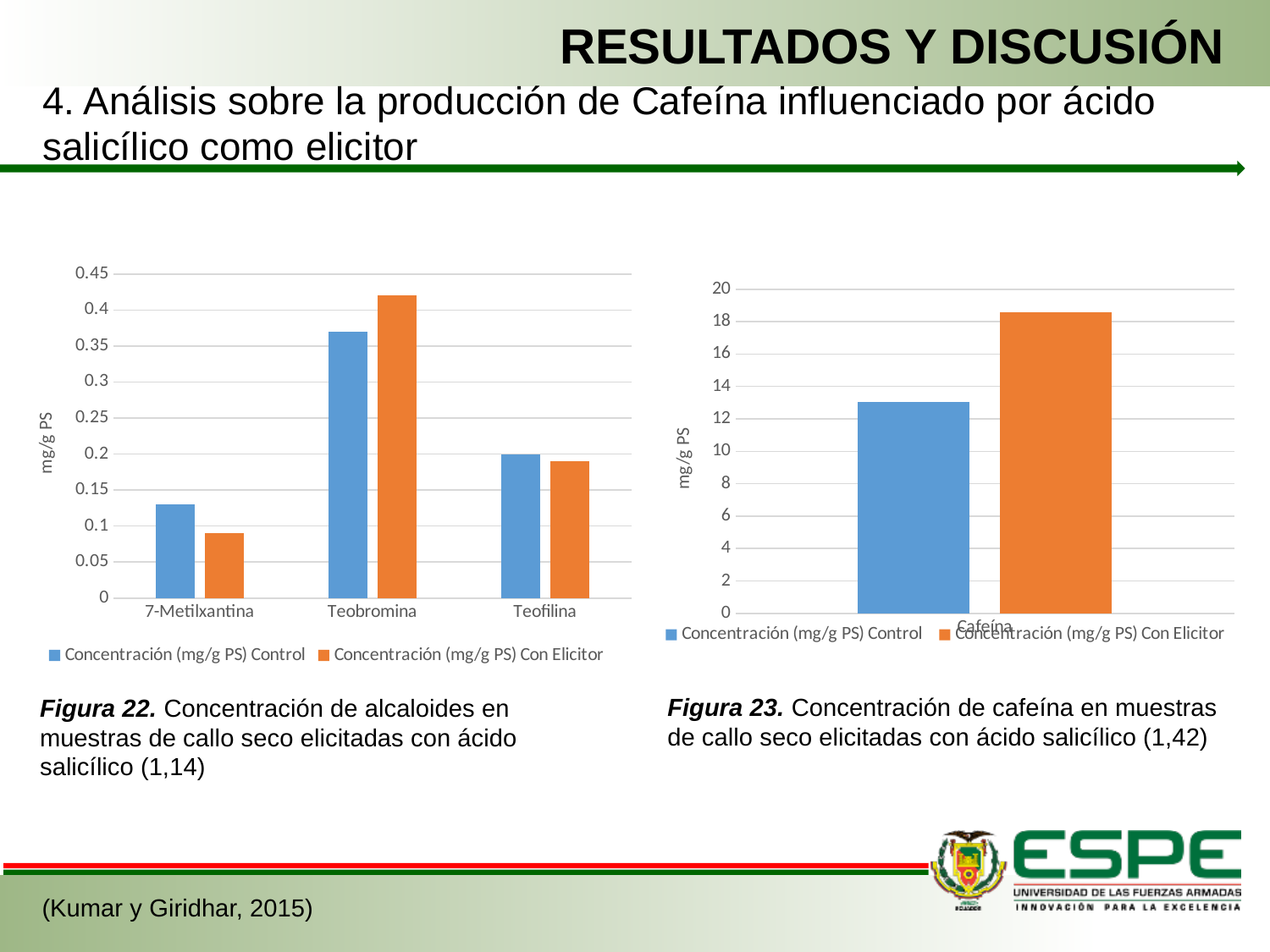
In the left chart (Figura 22), which category has the lowest Concentración (mg/g PS) Control value? 7-Metilxantina In the left chart (Figura 22), is the Concentración (mg/g PS) Con Elicitor value for 7-Metilxantina greater or less than 0.1? less In the right chart (Figura 23), is the Concentración (mg/g PS) Con Elicitor value for Cafeína greater or less than 18? greater In the left chart (Figura 22), how many series does the legend list? 2 In the left chart (Figura 22), is the Concentración (mg/g PS) Con Elicitor value for Teobromina greater or less than 0.4? greater What kind of chart is the left chart (Figura 22)? bar chart In the left chart (Figura 22), how many categories are shown on the x axis? 3 In the left chart (Figura 22), for 7-Metilxantina, which is larger: the Control value or the Con Elicitor value? Control In the left chart (Figura 22), which category has the highest Concentración (mg/g PS) Con Elicitor value? Teobromina In the left chart (Figura 22), for Teobromina, which is larger: the Control value or the Con Elicitor value? Con Elicitor What is the y-axis label of the right chart (Figura 23)? mg/g PS